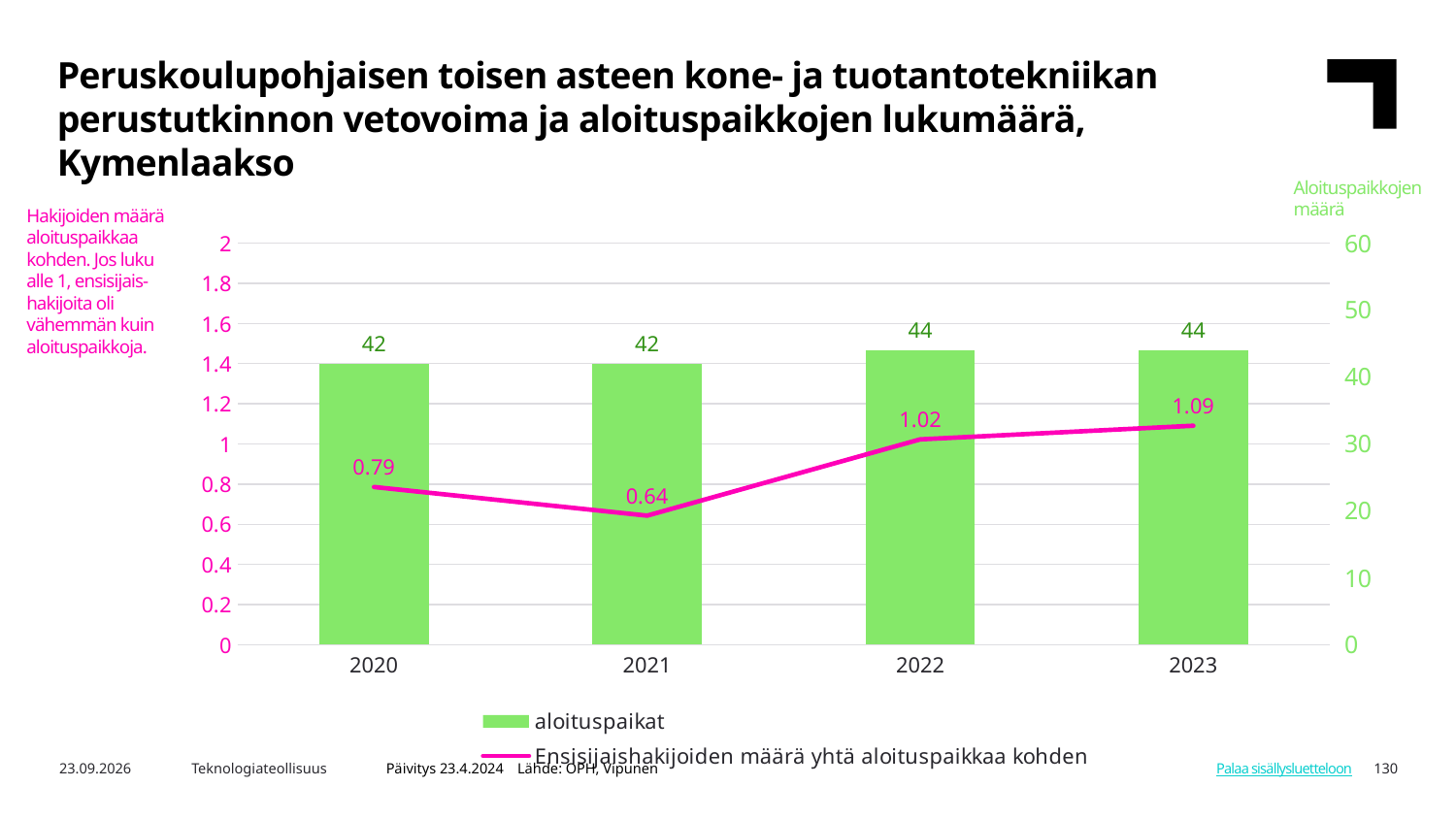
In which year is Ensisijaishakijoiden määrä yhtä aloituspaikkaa kohden lowest? 2021 Which year has a higher value of Ensisijaishakijoiden määrä yhtä aloituspaikkaa kohden, 2020 or 2022? 2022 What is the value of aloituspaikat for 2022? 44 Does the Ensisijaishakijoiden määrä yhtä aloituspaikkaa kohden line rise or fall from 2021 to 2023? rise In which year is Ensisijaishakijoiden määrä yhtä aloituspaikkaa kohden highest? 2023 How many years are shown on the x axis of the chart? 4 What is the difference between the Ensisijaishakijoiden määrä yhtä aloituspaikkaa kohden values for 2022 and 2021? 0.38 What is the difference in aloituspaikat between 2023 and 2020? 2 How many series does the chart legend list? 2 What is the value of Ensisijaishakijoiden määrä yhtä aloituspaikkaa kohden for 2023? 1.09 Is the value of Ensisijaishakijoiden määrä yhtä aloituspaikkaa kohden for 2020 greater or less than 1? less What is the value of Ensisijaishakijoiden määrä yhtä aloituspaikkaa kohden for 2021? 0.64